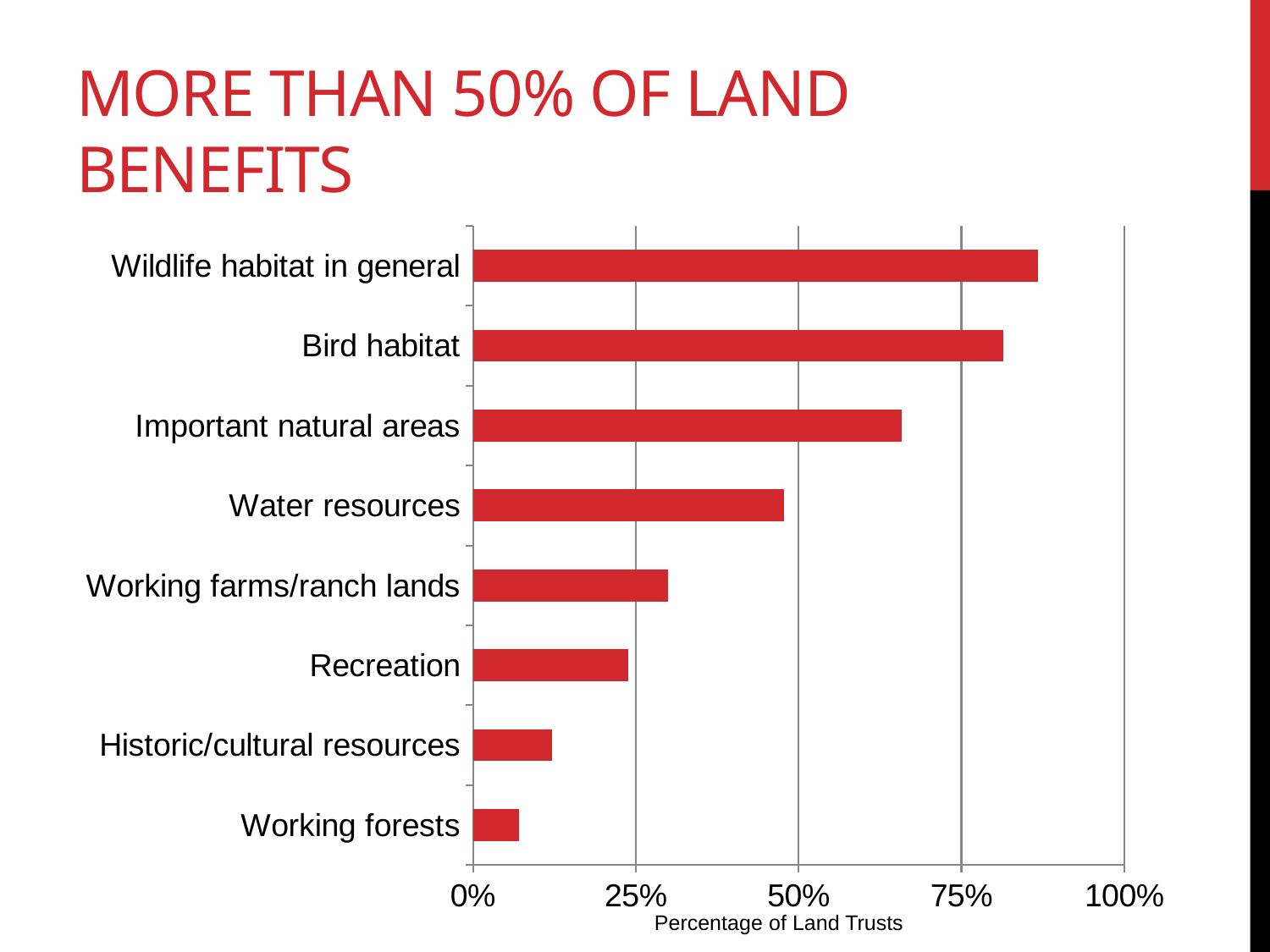
Is the value for Working forests greater or less than 25%? less What is the label on the horizontal axis of the chart? Percentage of Land Trusts What kind of chart is shown on the slide? bar chart Is the value for Important natural areas greater or less than 50%? greater Is the value for Working farms/ranch lands greater or less than 50%? less Which is larger, the value for Bird habitat or the value for Important natural areas? Bird habitat Which category has the lowest percentage of land trusts? Working forests Which category has the highest percentage of land trusts? Wildlife habitat in general How many categories are shown in the chart? 8 Which is larger, the value for Water resources or the value for Working farms/ranch lands? Water resources